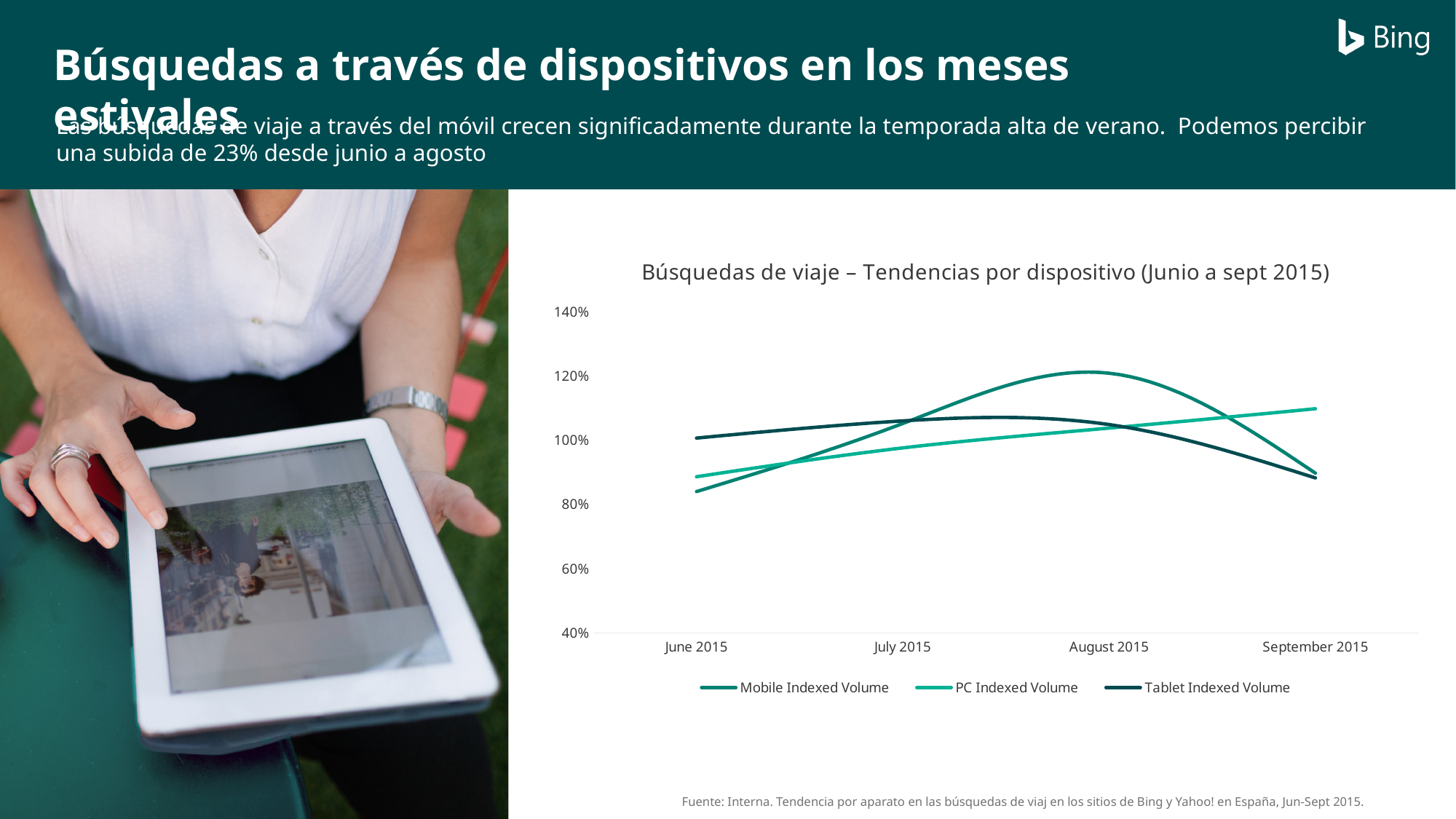
Which series has the lowest value in June 2015? Mobile Indexed Volume In August 2015, which is larger: Mobile Indexed Volume or PC Indexed Volume? Mobile Indexed Volume How many months are plotted along the x axis? 4 Is the value for Mobile Indexed Volume in August 2015 greater or less than 100%? greater How many series does the legend list? 3 Which series has the highest value in September 2015? PC Indexed Volume Which series has the highest value in June 2015? Tablet Indexed Volume In which month does Mobile Indexed Volume reach its highest value? August 2015 Is the value for Mobile Indexed Volume in June 2015 greater or less than 100%? less Does PC Indexed Volume rise or fall from June 2015 to September 2015? rise What kind of chart is shown on the slide? line chart Is the value for Tablet Indexed Volume in September 2015 greater or less than 100%? less